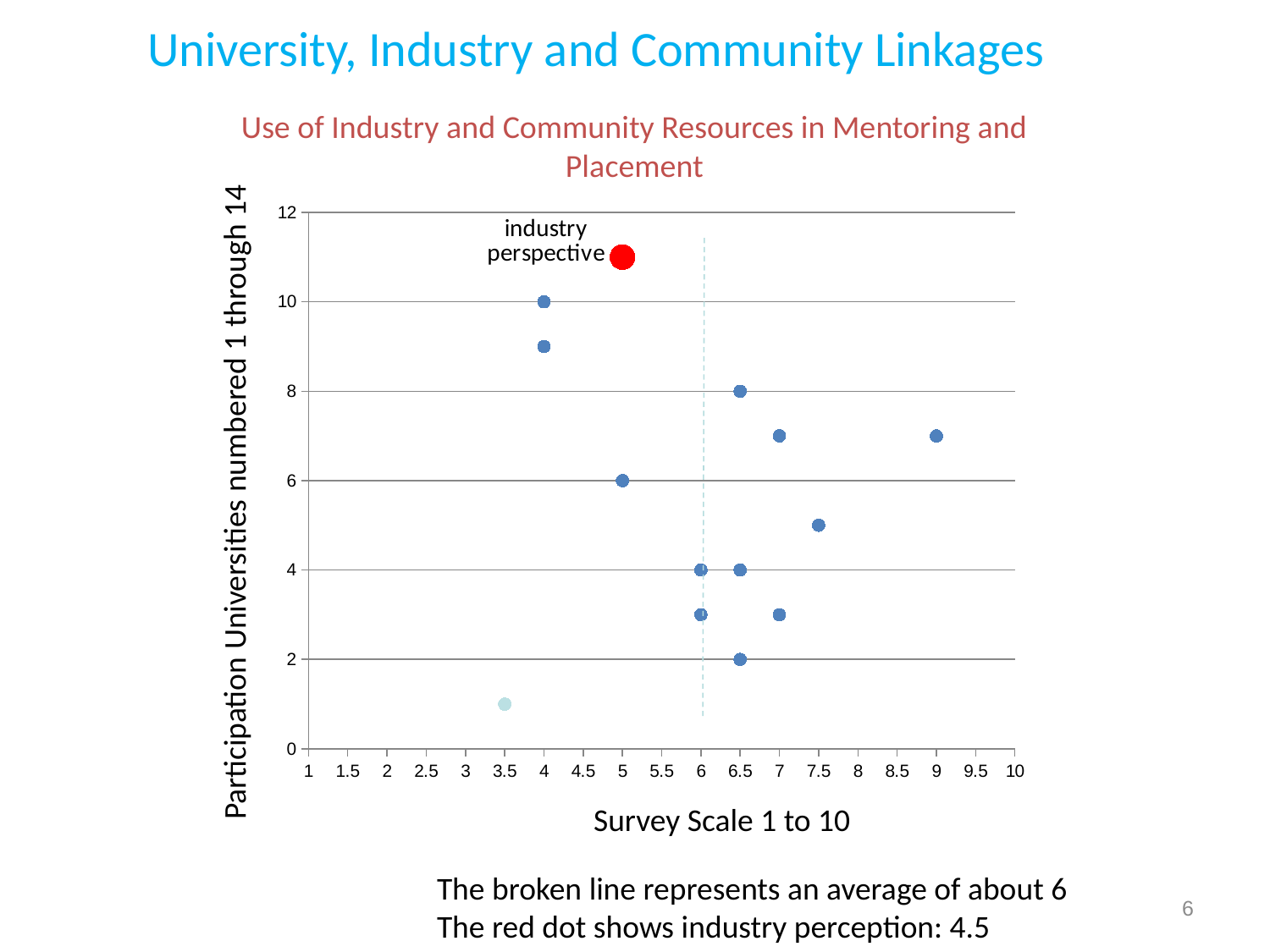
What is the highest survey scale value plotted for any participation university (excluding the red industry dot)? 9 What is the difference between the survey scale values for participation university 8 and participation university 6? 1.5 What survey scale value is plotted for participation university 6? 5 What is the x-axis title of the chart? Survey Scale 1 to 10 Which has the larger survey scale value, participation university 8 or participation university 6? participation university 8 Is the survey scale value for participation university 9 greater or less than 6? less What is the title of the chart? Use of Industry and Community Resources in Mentoring and Placement What is the lowest survey scale value plotted for any participation university? 3.5 What survey scale value is plotted for participation university 5? 7.5 What survey scale value is plotted for participation university 10? 4 What survey scale value is plotted for participation university 8? 6.5 What kind of chart is shown on the slide? scatter chart